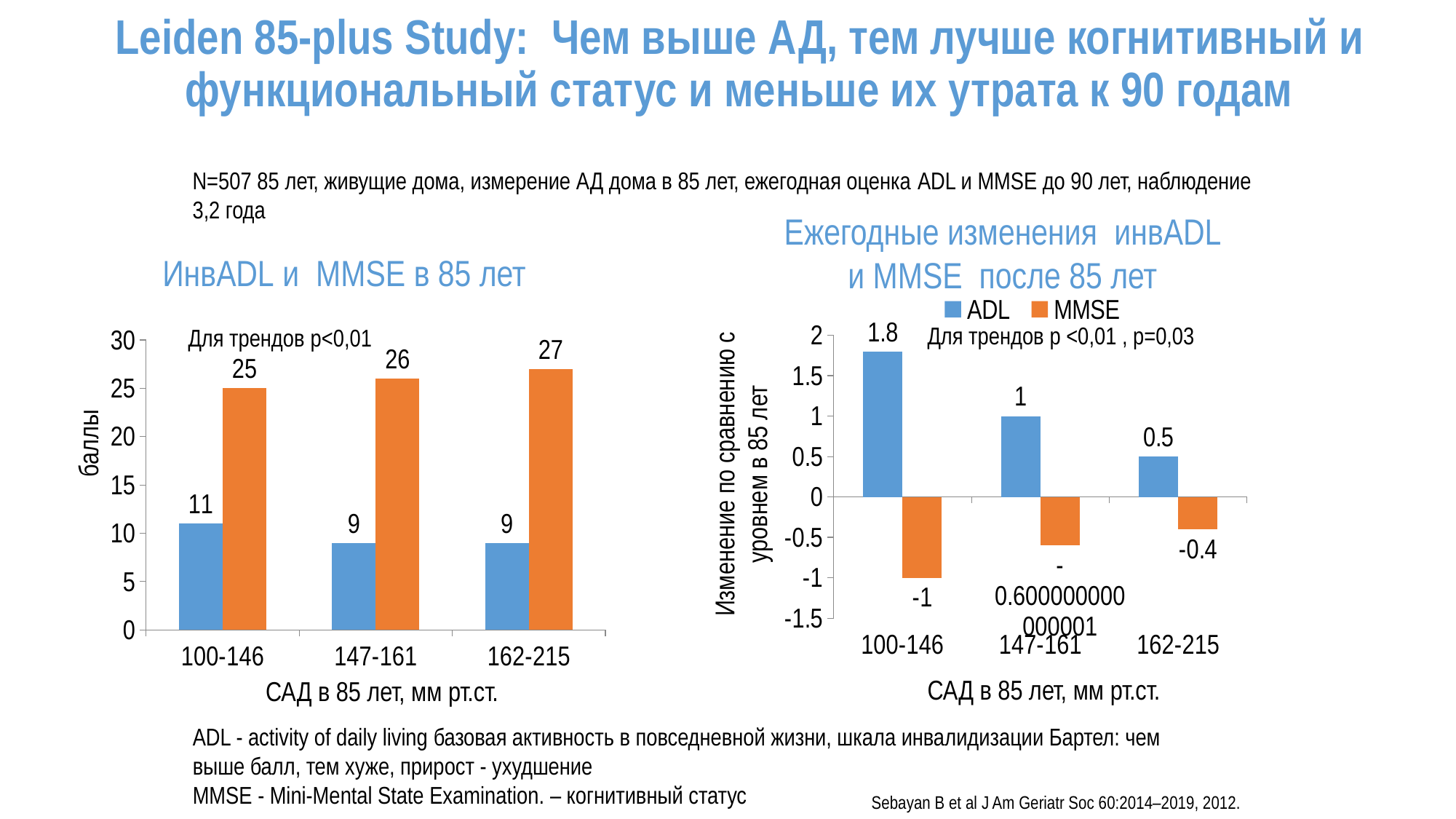
In the left chart 'ИнвADL и MMSE в 85 лет', which category has the highest orange bar? 162-215 In the right chart 'Ежегодные изменения инвADL и MMSE после 85 лет', is the ADL value for 147-161 larger or smaller than the ADL value for 100-146? smaller In the left chart 'ИнвADL и MMSE в 85 лет', what is the value of the blue bar for the 100-146 category? 11 In the left chart 'ИнвADL и MMSE в 85 лет', how many categories are shown on the x axis? 3 In the right chart 'Ежегодные изменения инвADL и MMSE после 85 лет', how many series does the legend list? 2 In the right chart 'Ежегодные изменения инвADL и MMSE после 85 лет', what is the MMSE value for the 162-215 category? -0.4 In the right chart 'Ежегодные изменения инвADL и MMSE после 85 лет', which category has the lowest ADL value? 162-215 What type of chart is the right chart 'Ежегодные изменения инвADL и MMSE после 85 лет'? bar chart In the left chart 'ИнвADL и MMSE в 85 лет', do the orange bars rise or fall from left to right across the categories? rise In the left chart 'ИнвADL и MMSE в 85 лет', what is the difference between the orange and blue bars for the 100-146 category? 14 In the right chart 'Ежегодные изменения инвADL и MMSE после 85 лет', what is the ADL value for the 100-146 category? 1.8 In the left chart 'ИнвADL и MMSE в 85 лет', what is the value of the orange bar for the 162-215 category? 27